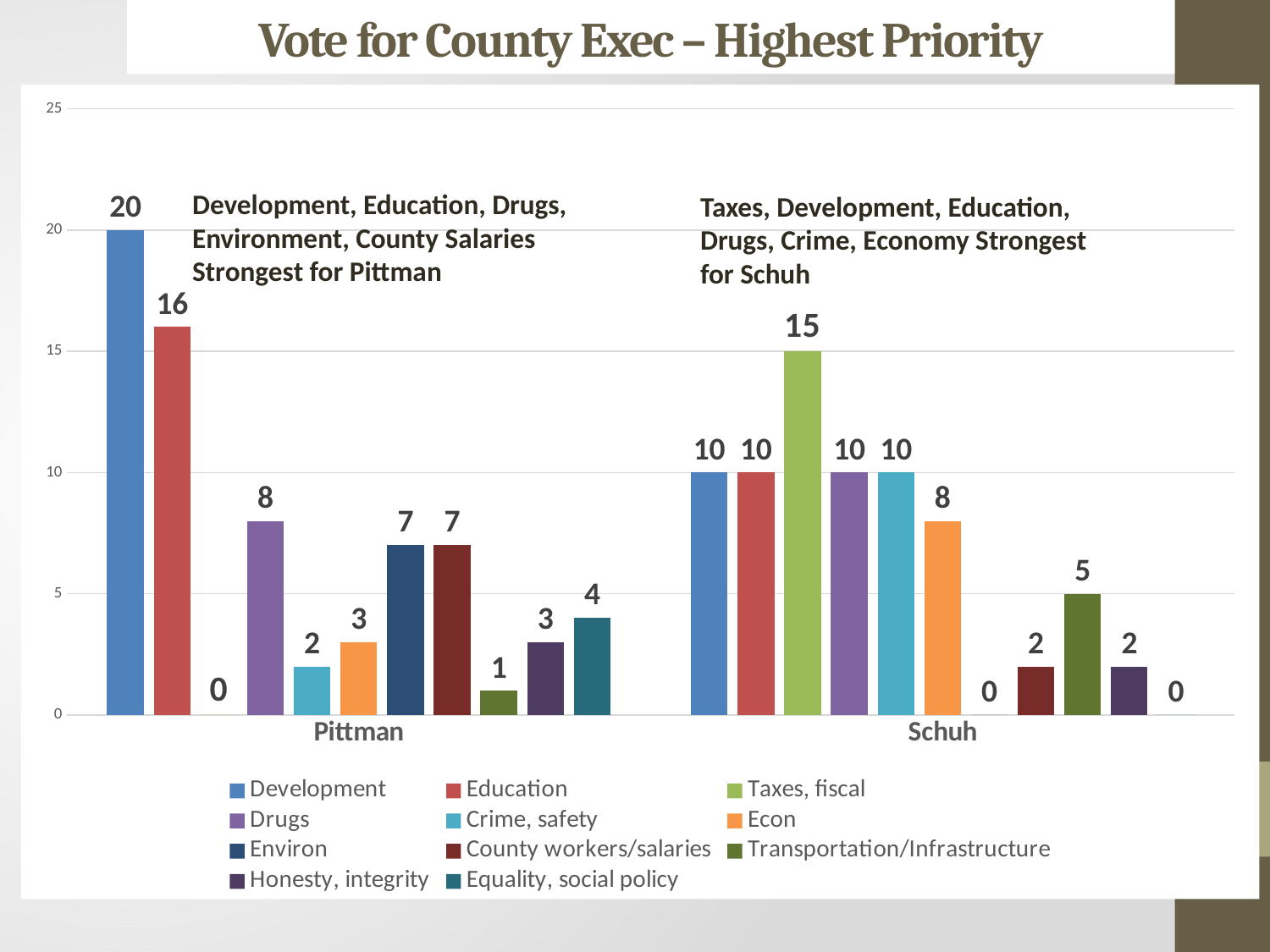
What is the title of the chart? Vote for County Exec – Highest Priority What is the value for Environ for Schuh? 0 What is the value for Development for Pittman? 20 What is the value for Drugs for Pittman? 8 Which series has the lowest value for Pittman? Taxes, fiscal What is the value for Taxes, fiscal for Schuh? 15 What is the difference between the Development value for Pittman and the Development value for Schuh? 10 How many categories are shown on the x axis? 2 How many series does the legend list? 11 What kind of chart is shown on the slide? Bar chart Which is larger: the Education value for Pittman or the Education value for Schuh? Pittman Which series has the highest value for Schuh? Taxes, fiscal